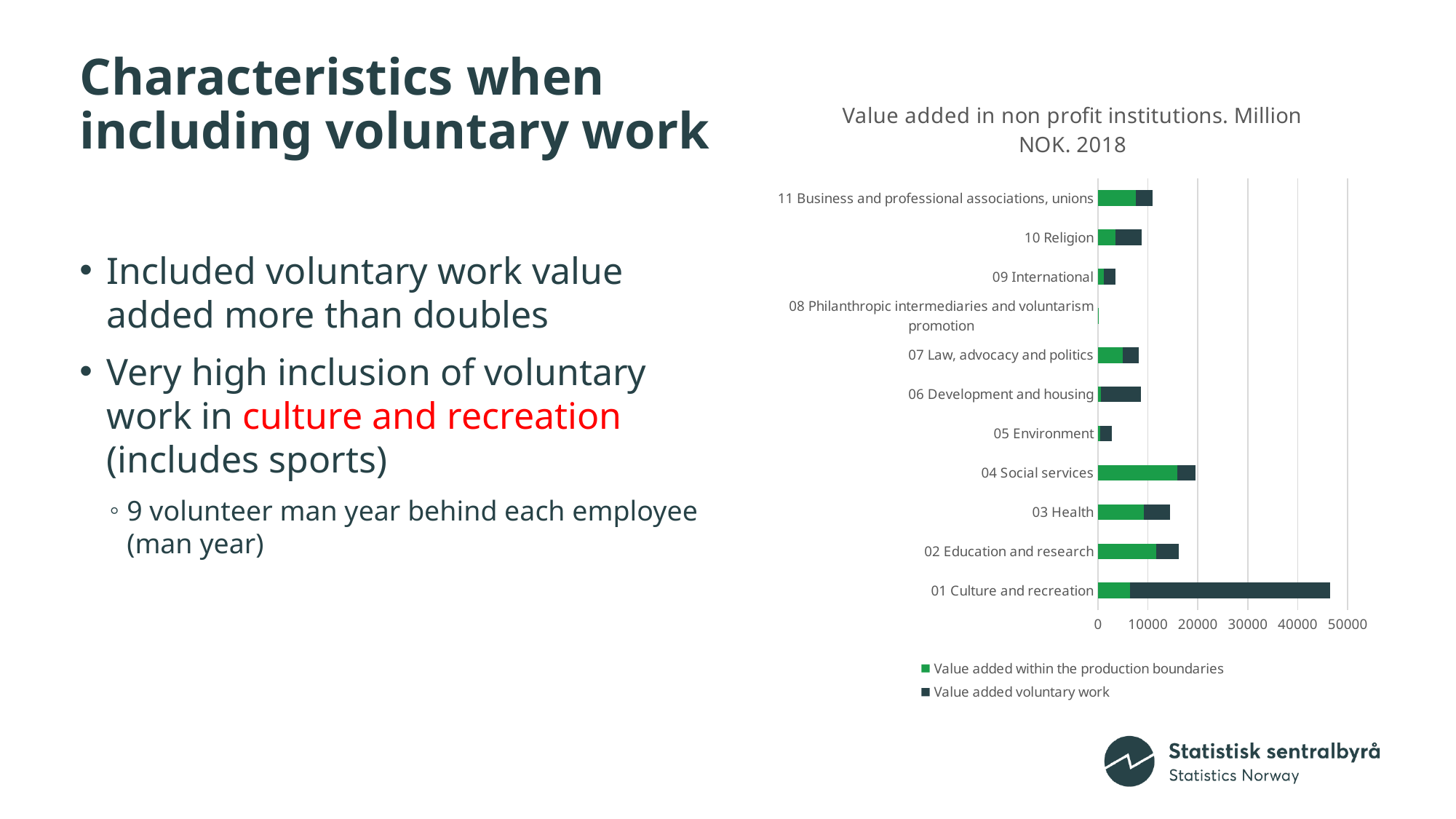
Is the total value for 02 Education and research greater or less than 10000? greater Which category has the longest total bar in the chart? 01 Culture and recreation What is the title of the chart? Value added in non profit institutions. Million NOK. 2018 Which series in the legend is shown in dark colour? Value added voluntary work Is the total value for 01 Culture and recreation greater or less than 40000? greater How many categories are plotted in the chart? 11 Is the total value for 05 Environment greater or less than 10000? less How many series does the chart's legend list? 2 Which has a larger total bar, 04 Social services or 10 Religion? 04 Social services What kind of chart is shown on the slide? Bar chart Which category has the shortest total bar in the chart? 08 Philanthropic intermediaries and voluntarism promotion